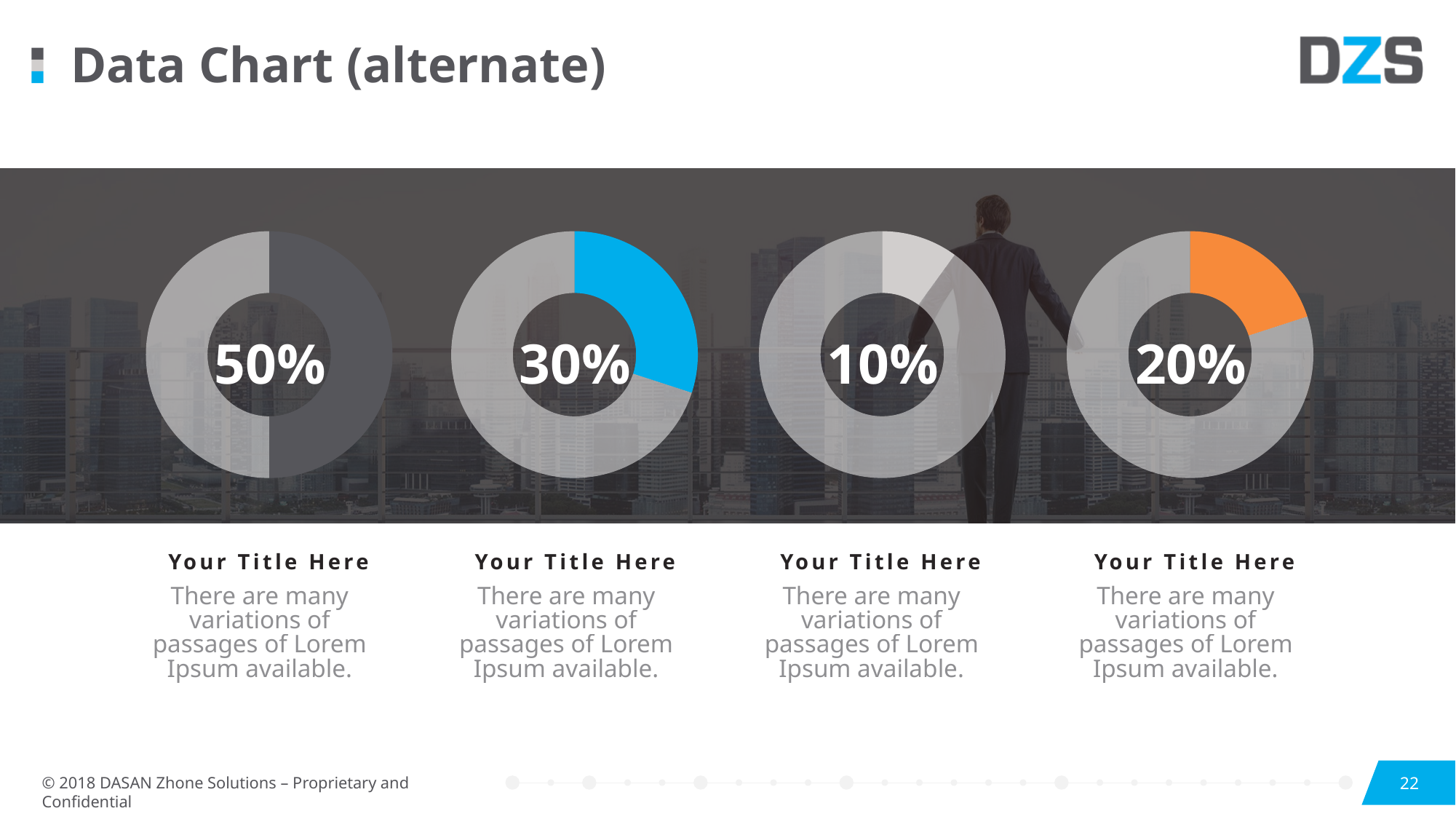
What percentage is shown in the third donut chart from the left? 10% What kind of chart is used to display the percentages on this slide? Donut chart Which donut chart shows the highest percentage? The leftmost chart (50%) What percentage is shown in the second donut chart from the left? 30% What colour is the highlighted segment in the rightmost donut chart? Orange Which donut chart shows the lowest percentage? The third chart from the left (10%) What is the difference between the percentage in the leftmost donut chart and the percentage in the rightmost donut chart? 30% What percentage is shown in the leftmost donut chart? 50% What percentage is shown in the rightmost donut chart? 20% How many donut charts are shown on the slide? 4 What colour is the highlighted segment in the second donut chart from the left? Blue Which is larger: the percentage in the second donut chart from the left or the percentage in the rightmost donut chart? The second chart from the left (30%)